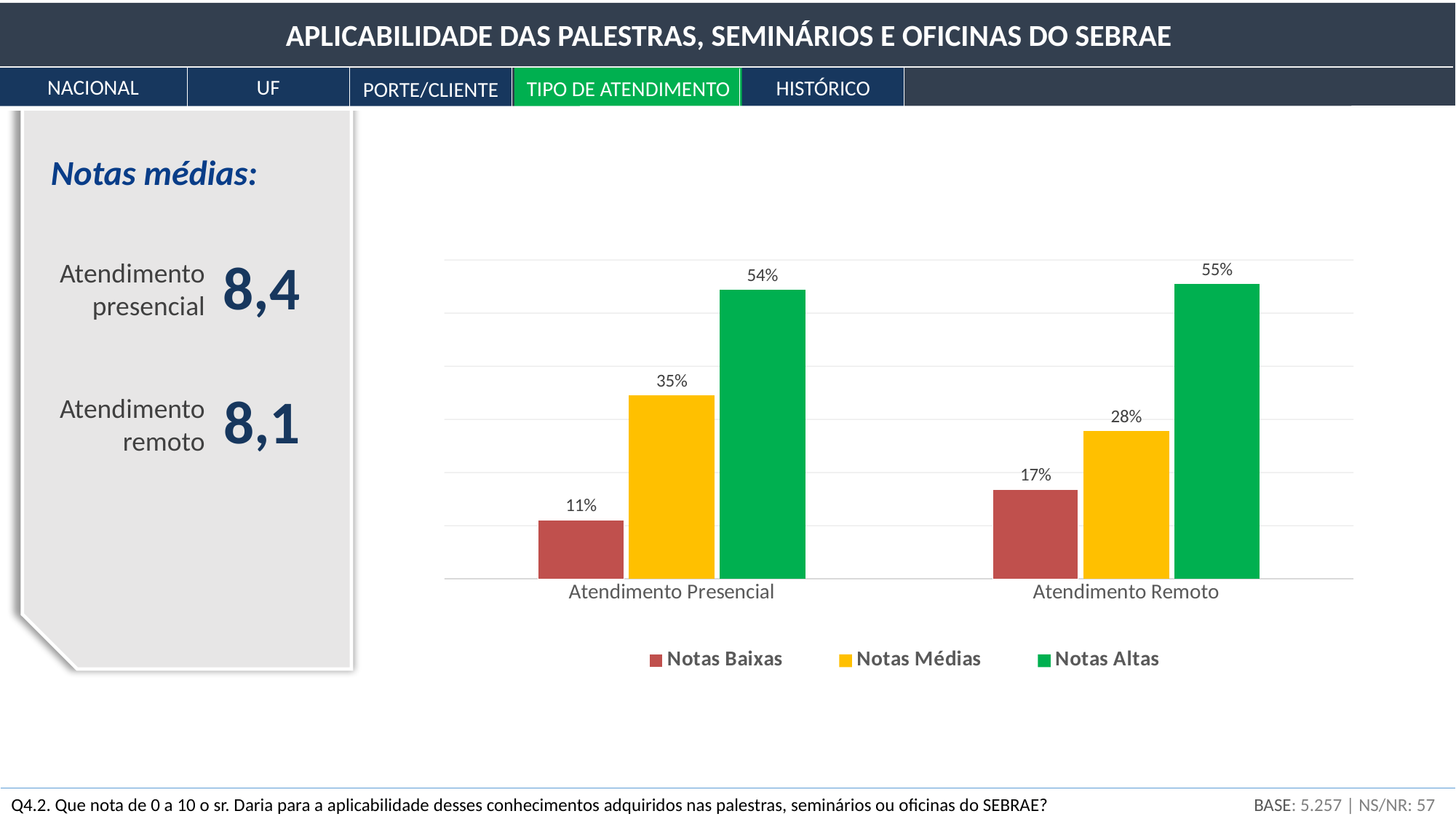
Which series has the lowest value in the Atendimento Presencial category? Notas Baixas How many categories are shown on the x axis of the chart? 2 What kind of chart is shown on the slide? Bar chart What is the value for Notas Médias in the Atendimento Presencial category? 35% What is the difference between Notas Baixas for Atendimento Remoto and Atendimento Presencial? 6% What is the value for Notas Altas in the Atendimento Presencial category? 54% Which series has the highest value in the Atendimento Remoto category? Notas Altas What is the difference between Notas Médias for Atendimento Presencial and Atendimento Remoto? 7% Which is larger: Notas Altas for Atendimento Presencial or Notas Altas for Atendimento Remoto? Atendimento Remoto What is the value for Notas Médias in the Atendimento Remoto category? 28% What is the value for Notas Baixas in the Atendimento Remoto category? 17% How many series does the chart legend list? 3